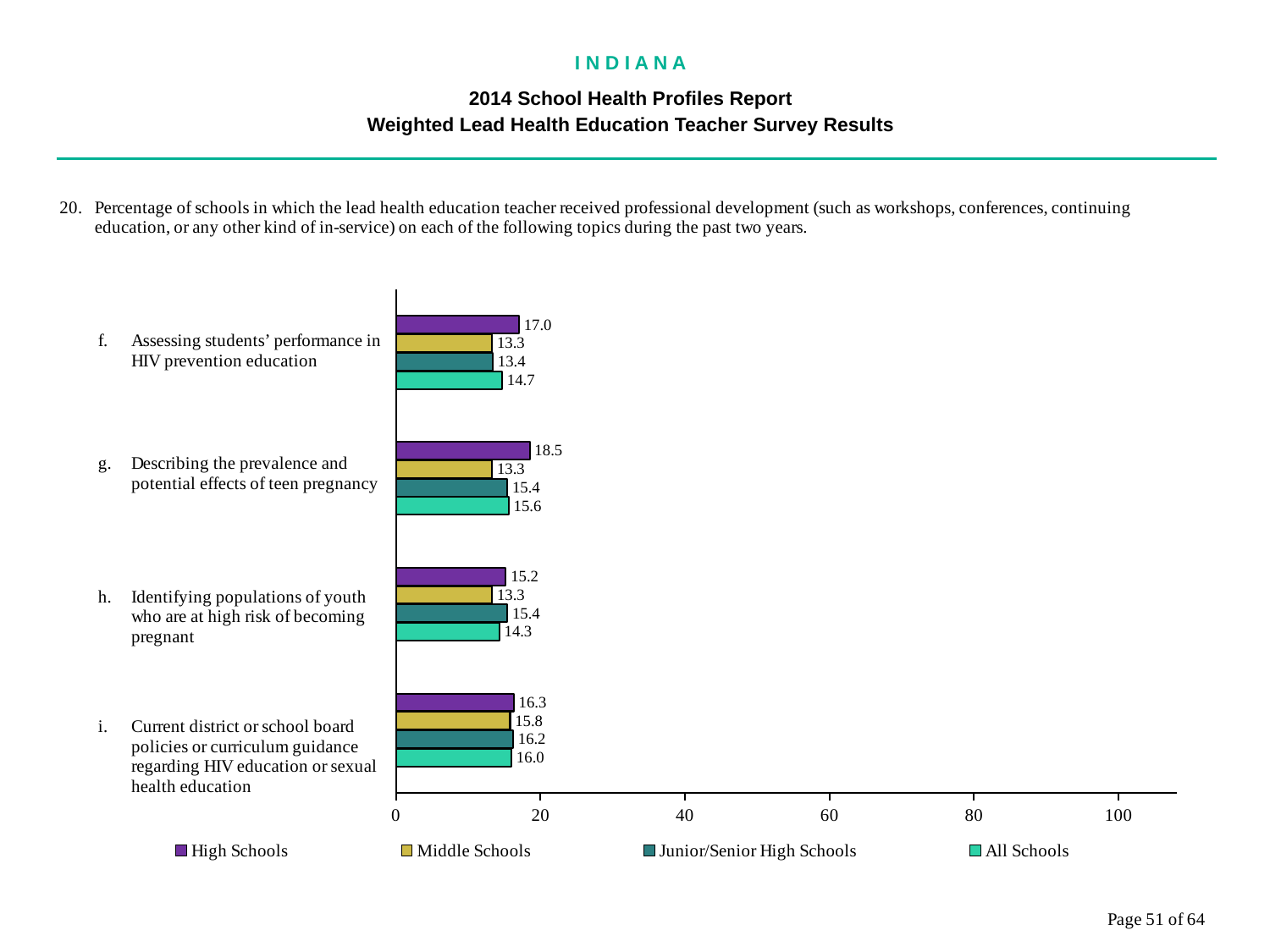
Is the High Schools value for 'Describing the prevalence and potential effects of teen pregnancy' greater or less than 20? less How many topics are shown on the chart? 4 What kind of chart is shown on the slide? bar chart What is the Junior/Senior High Schools value for 'Identifying populations of youth who are at high risk of becoming pregnant'? 15.4 Which topic has the highest High Schools value? Describing the prevalence and potential effects of teen pregnancy How many series does the legend list? 4 What is the High Schools value for 'Describing the prevalence and potential effects of teen pregnancy'? 18.5 Which is larger for 'Identifying populations of youth who are at high risk of becoming pregnant': the High Schools value or the Junior/Senior High Schools value? Junior/Senior High Schools What is the All Schools value for 'Assessing students' performance in HIV prevention education'? 14.7 What is the Middle Schools value for 'Current district or school board policies or curriculum guidance regarding HIV education or sexual health education'? 15.8 Which topic has the lowest All Schools value? Identifying populations of youth who are at high risk of becoming pregnant What is the difference between the High Schools and Middle Schools values for 'Assessing students' performance in HIV prevention education'? 3.7